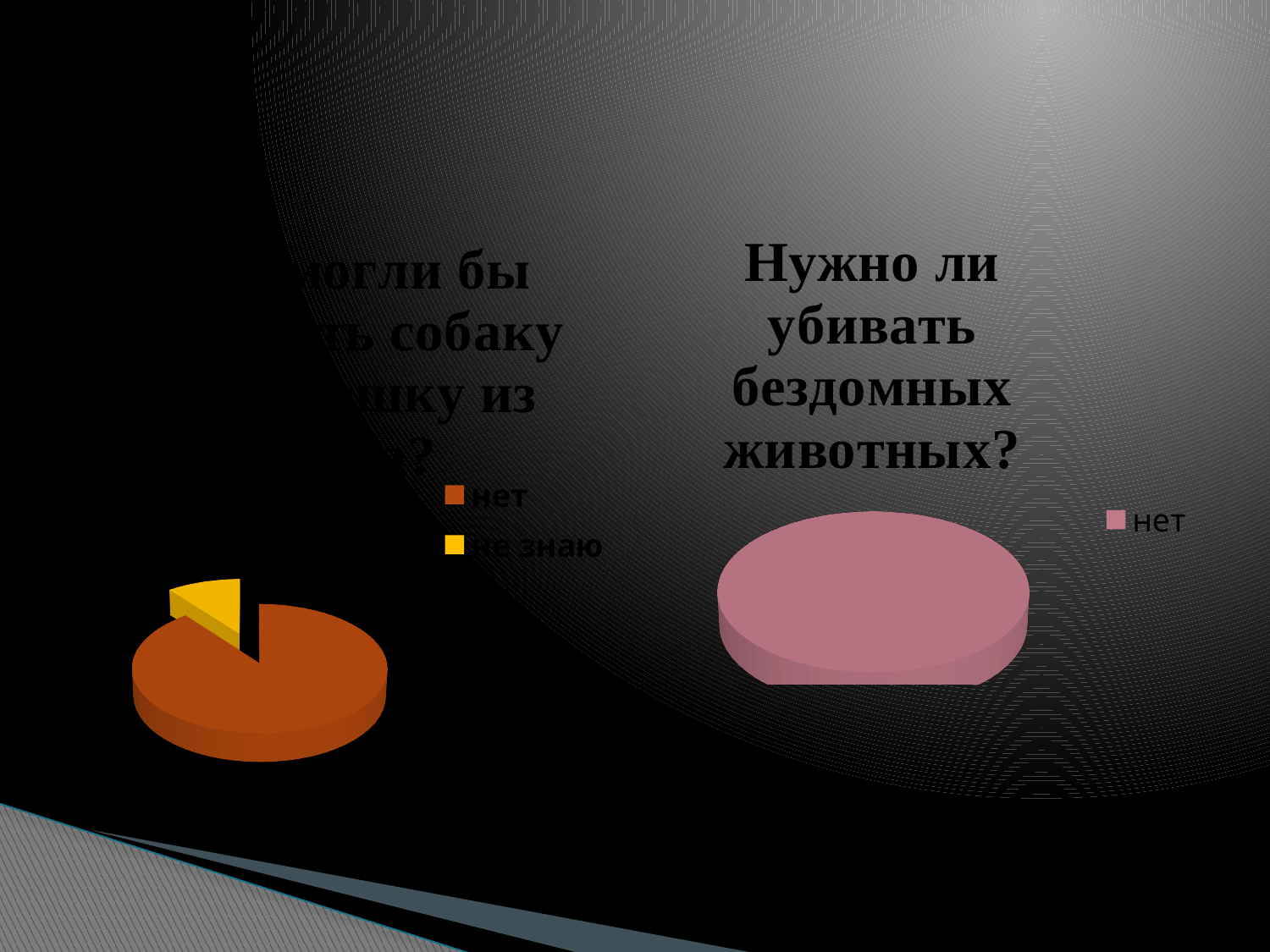
In the left chart, which category has the smallest slice? не знаю What is the only category shown in the chart titled "Нужно ли убивать бездомных животных?"? нет In the left chart, which slice is larger, "нет" or "не знаю"? нет In the left chart, which category has the largest slice? нет How many slices does the left chart have? 2 What kind of chart is the left chart on the slide? pie chart How many slices does the chart titled "Нужно ли убивать бездомных животных?" have? 1 What kind of chart is the chart titled "Нужно ли убивать бездомных животных?"? pie chart How many entries does the legend of the chart titled "Нужно ли убивать бездомных животных?" list? 1 How many entries does the legend of the left chart list? 2 In the left chart, what colour is the "не знаю" slice? yellow What is the title of the chart on the right side of the slide? Нужно ли убивать бездомных животных?